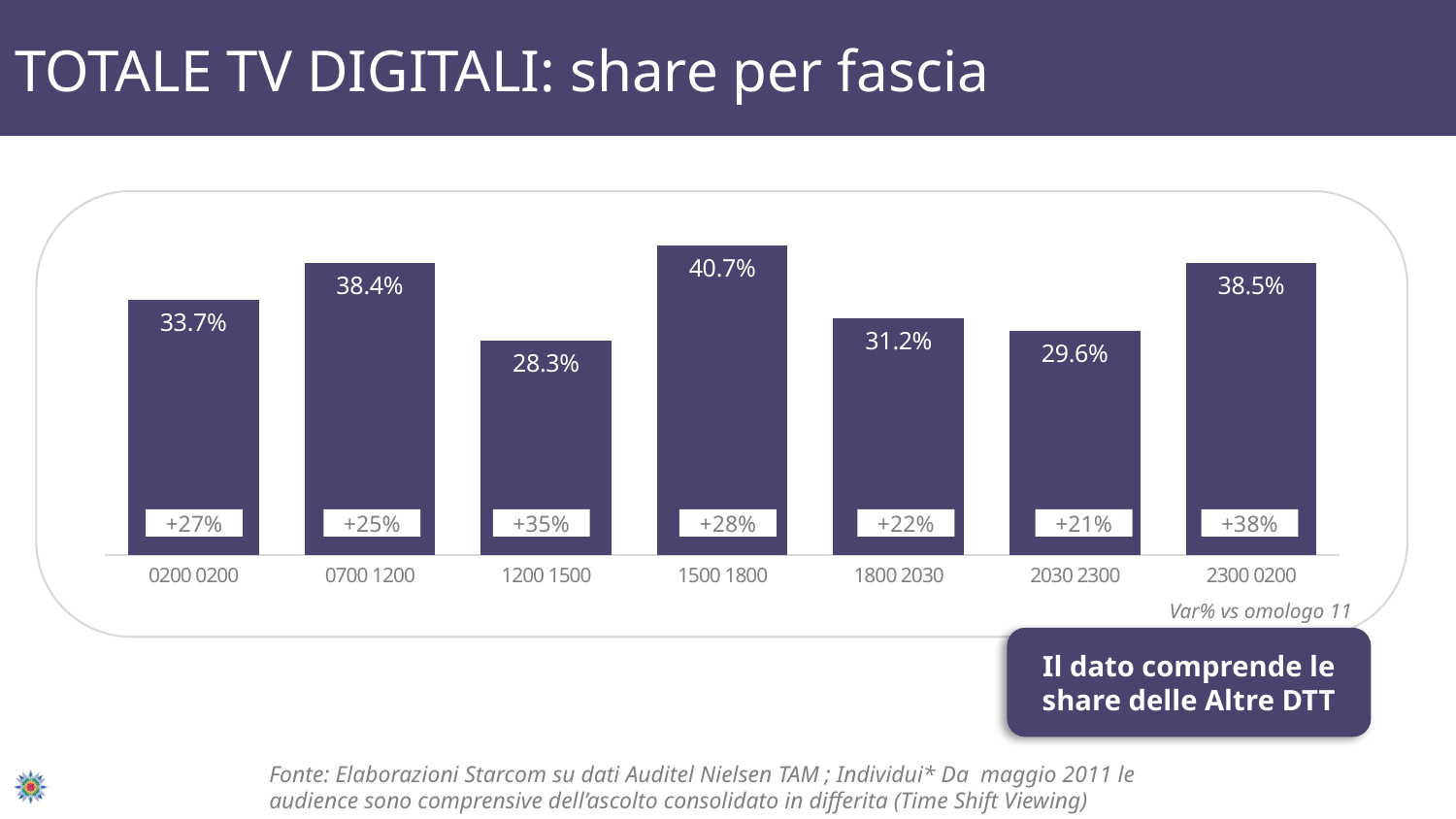
What is the Var% vs omologo 11 shown for the 2300 0200 time band? +38% Which time band has the lowest share? 1200 1500 What is the share for the 1500 1800 time band? 40.7% How many time bands are shown in the chart? 7 Which time band has the highest share? 1500 1800 What is the difference in share between the 1500 1800 and 1200 1500 time bands? 12.4 percentage points Which time band has the smallest Var% vs omologo 11? 2030 2300 What is the Var% vs omologo 11 shown for the 1200 1500 time band? +35% What is the title of the slide? TOTALE TV DIGITALI: share per fascia What kind of chart is shown on the slide? Bar chart Which has a larger share, the 0200 0200 band or the 1800 2030 band? 0200 0200 What is the share for the 2030 2300 time band? 29.6%